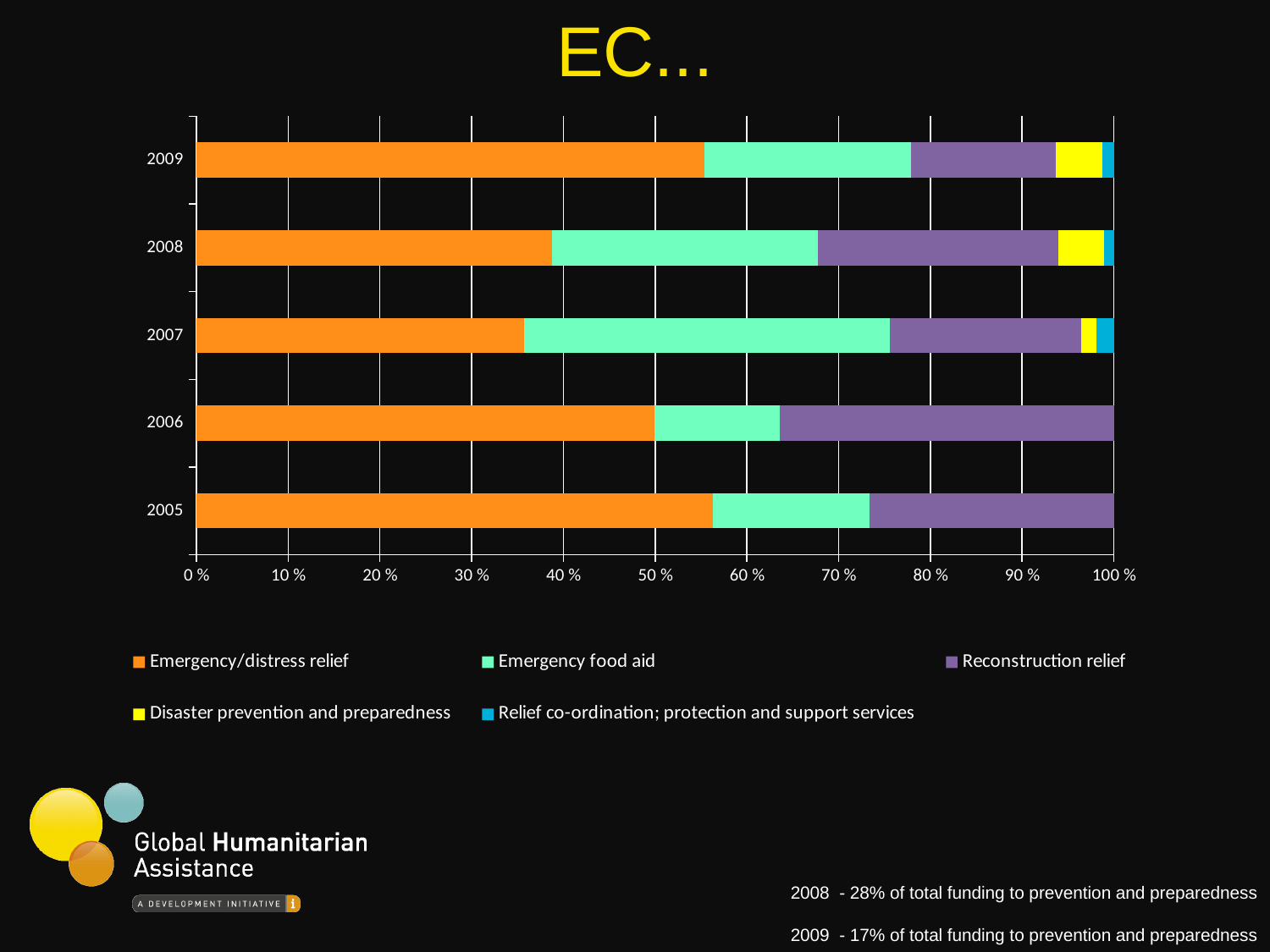
What kind of chart is shown on the slide? Bar chart How many series does the legend list? 5 Which year has the larger Emergency/distress relief share, 2009 or 2008? 2009 Is the Emergency/distress relief share for 2007 greater or less than 40%? less Which year has the largest Emergency food aid share? 2007 Which year has the largest Reconstruction relief share? 2006 Is the Emergency/distress relief share for 2009 greater or less than 50%? greater What is the title of the chart? EC... Is the Emergency/distress relief share for 2006 greater or less than 60%? less Which colour represents Disaster prevention and preparedness in the legend? Yellow Which year has the larger Emergency food aid share, 2007 or 2006? 2007 How many years are shown on the chart? 5